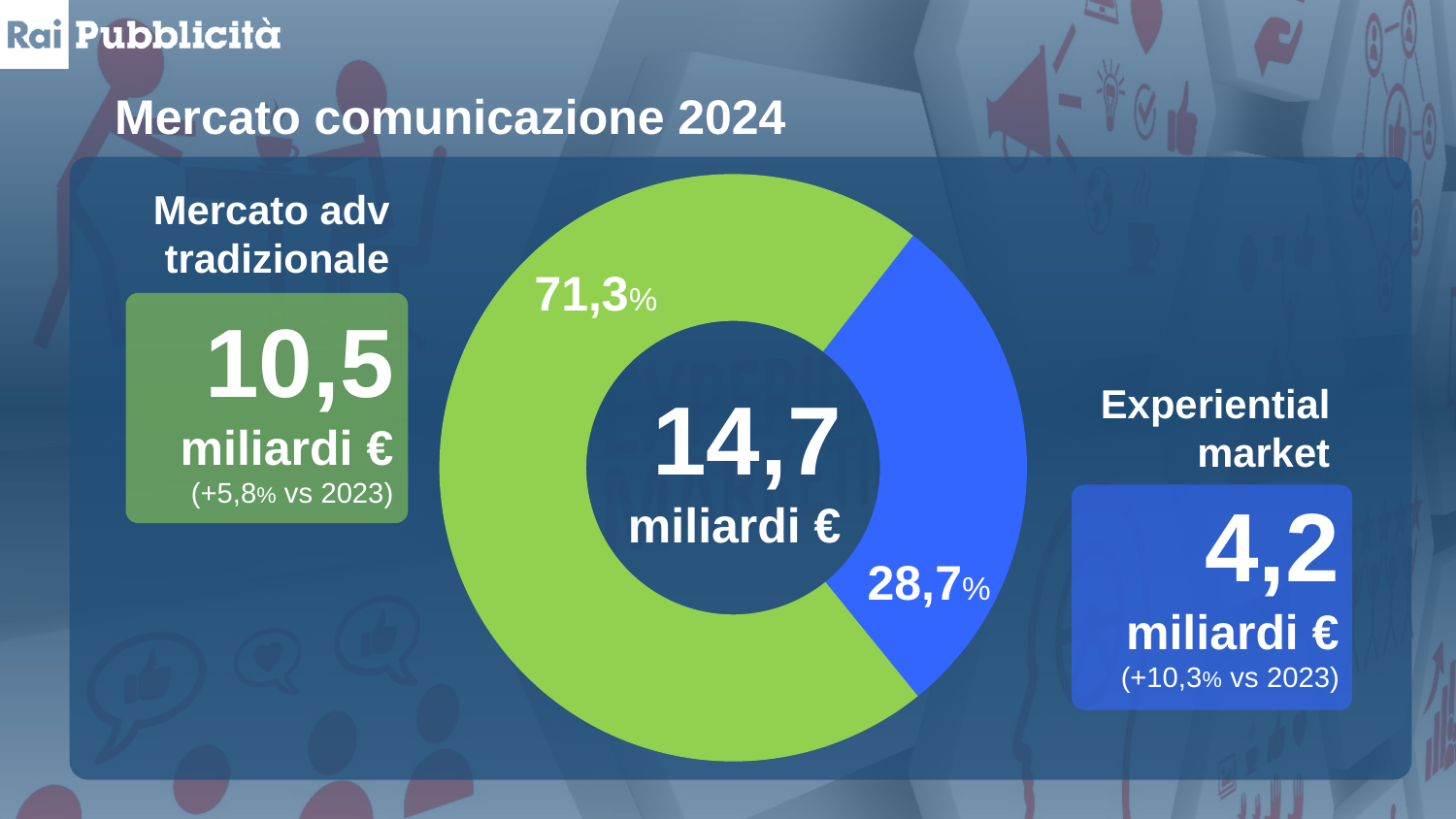
What is the title of the slide containing the donut chart? Mercato comunicazione 2024 What kind of chart is shown on the slide? Donut chart What share of the donut chart does the blue slice (Experiential market) represent? 28,7% Which grew more versus 2023, Mercato adv tradizionale or Experiential market? Experiential market (+10,3%) What is the difference in percentage points between the two slices of the donut chart (71,3% and 28,7%)? 42,6 percentage points Which slice of the donut chart is the largest? Mercato adv tradizionale (71,3%) What is the value shown for Experiential market? 4,2 miliardi € What total value is shown in the centre of the donut chart? 14,7 miliardi € What is the value shown for Mercato adv tradizionale? 10,5 miliardi € What share of the donut chart does the green slice (Mercato adv tradizionale) represent? 71,3% How many slices does the donut chart have? 2 Which slice of the donut chart is the smallest? Experiential market (28,7%)